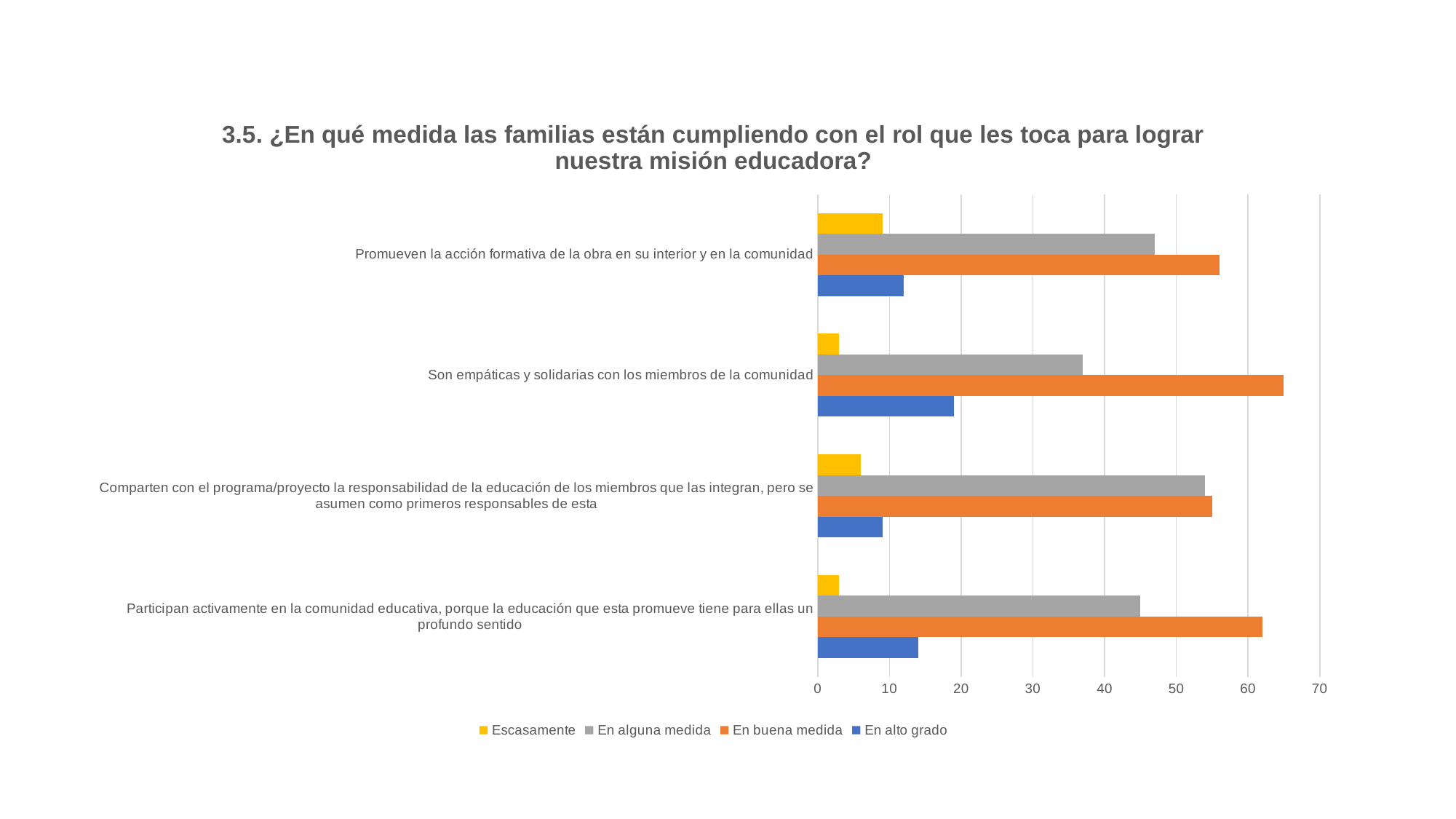
Is the value of 'Escasamente' for 'Comparten con el programa/proyecto la responsabilidad de la educación de los miembros que las integran, pero se asumen como primeros responsables de esta' greater or less than 10? less Which series has the lowest value for 'Promueven la acción formativa de la obra en su interior y en la comunidad'? Escasamente How many series does the legend list? 4 What colour represents the 'En buena medida' series in the legend? orange Which is larger: 'En alto grado' for 'Son empáticas y solidarias con los miembros de la comunidad' or 'En alto grado' for 'Comparten con el programa/proyecto la responsabilidad de la educación de los miembros que las integran, pero se asumen como primeros responsables de esta'? Son empáticas y solidarias con los miembros de la comunidad How many categories (statements) are plotted on the chart? 4 Is the value of 'En alguna medida' for 'Promueven la acción formativa de la obra en su interior y en la comunidad' greater or less than 40? greater Is the value of 'En alto grado' for 'Son empáticas y solidarias con los miembros de la comunidad' greater or less than 10? greater What kind of chart is shown on the slide? bar chart Which statement has the highest value for 'En buena medida'? Son empáticas y solidarias con los miembros de la comunidad For 'Son empáticas y solidarias con los miembros de la comunidad', which is larger: 'En buena medida' or 'En alguna medida'? En buena medida